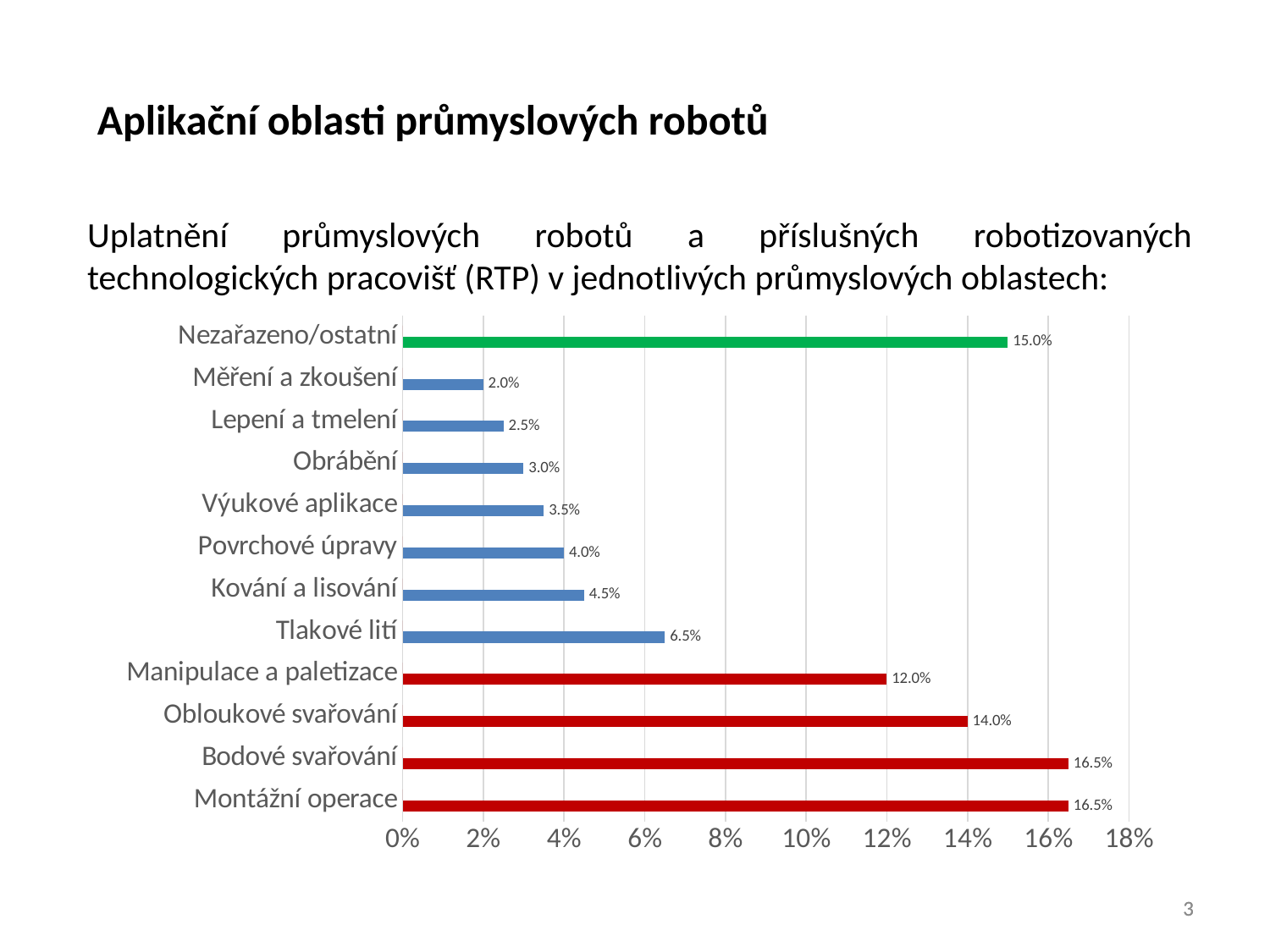
What colour is the bar for Nezařazeno/ostatní? green What is the value for Obloukové svařování? 14.0% What is the difference between the values for Bodové svařování and Nezařazeno/ostatní? 1.5% What is the value for Nezařazeno/ostatní? 15.0% What is the value for Tlakové lití? 6.5% Is the value for Tlakové lití greater or less than 6%? greater Which category has the lowest value? Měření a zkoušení What kind of chart is shown on the slide? bar chart What is the difference between the values for Obloukové svařování and Manipulace a paletizace? 2.0% What is the value for Manipulace a paletizace? 12.0% Which is larger, the value for Kování a lisování or the value for Povrchové úpravy? Kování a lisování How many categories are plotted in the chart? 12